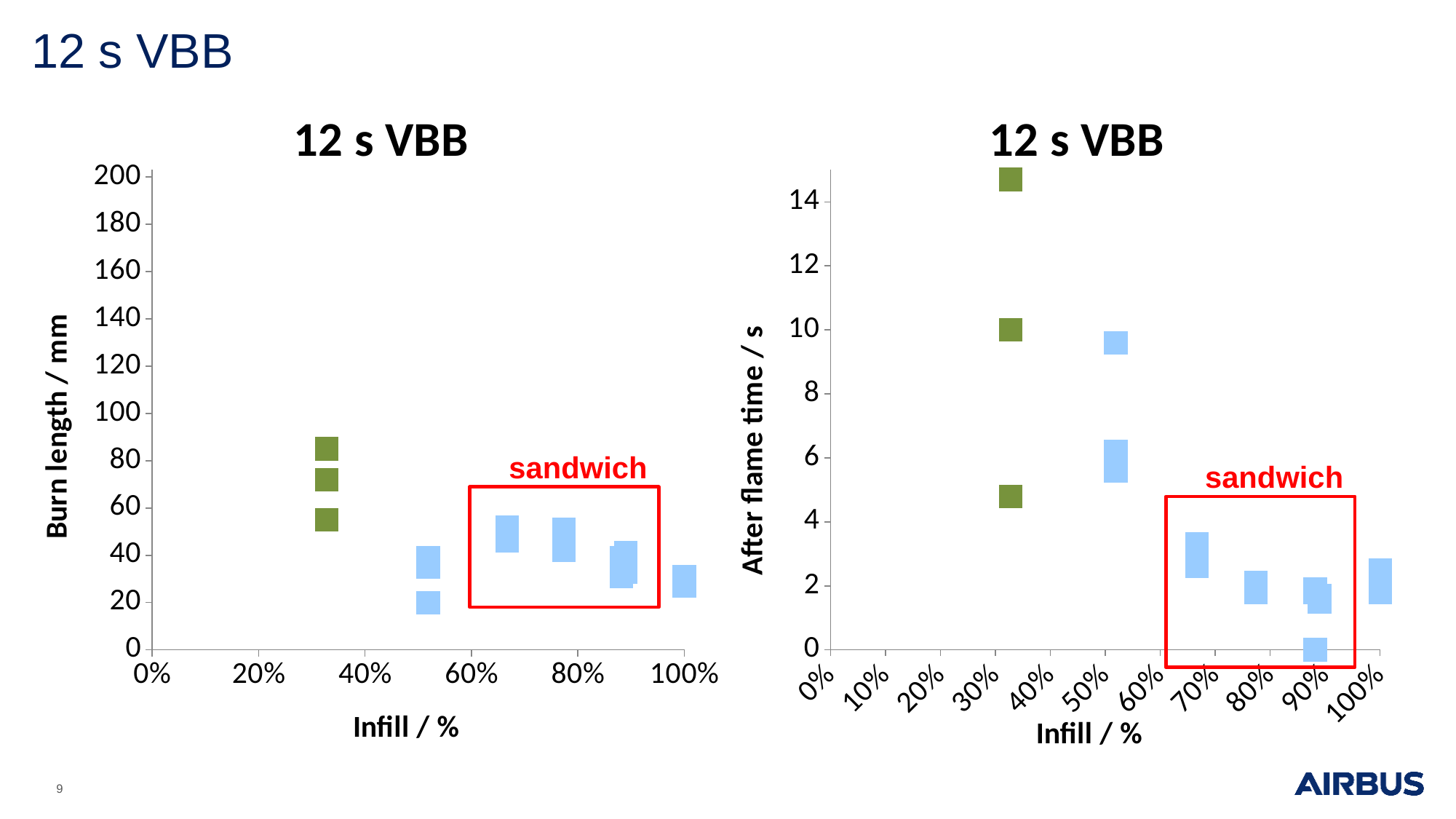
In the left chart, do the green markers or the blue markers reach the higher burn length? green What is the y-axis title of the left chart? Burn length / mm What is the y-axis title of the right chart? After flame time / s In the left chart, is the burn length of the blue marker at 100% infill greater or less than 40 mm? less In the right chart, how many green markers are plotted? 3 In the left chart, do the burn lengths inside the red 'sandwich' box rise or fall as infill increases from about 65% to 90%? fall In the right chart, is the highest green marker's after flame time greater or less than 12 s? greater In the right chart, are the blue markers at 90% infill greater or less than 4 s after flame time? less What kind of chart is the left chart on the slide? scatter chart In the left chart, how many green markers are plotted? 3 In the right chart, do the after flame times inside the red 'sandwich' box rise or fall as infill increases from 70% to 90%? fall